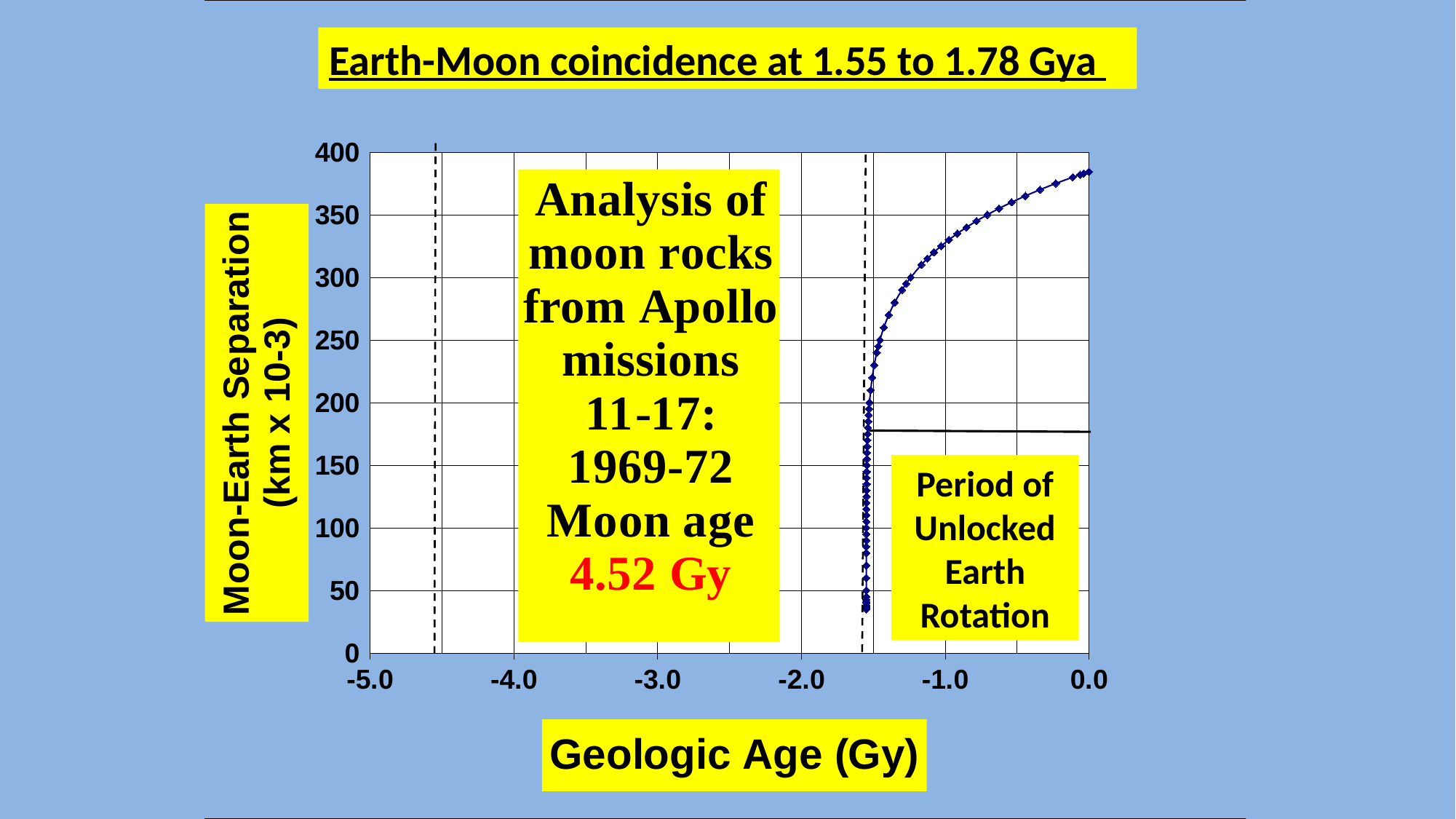
What is the title of the slide's chart? Earth-Moon coincidence at 1.55 to 1.78 Gya Which has the smaller Moon-Earth separation: Geologic Age -1.5 or Geologic Age -0.5? -1.5 What kind of chart is shown on the slide? line chart What is the highest tick value shown on the y axis? 400 What is the label of the x axis? Geologic Age (Gy) Is the Moon-Earth separation at Geologic Age -1.0 greater or less than 300? greater Does the Moon-Earth separation rise or fall as Geologic Age moves from -1.5 toward 0.0 along the x axis? rise Is the Moon-Earth separation at Geologic Age -1.5 greater or less than 300? less Which has the larger Moon-Earth separation: Geologic Age -1.0 or Geologic Age 0.0? 0.0 Is the Moon-Earth separation at Geologic Age 0.0 greater or less than 350? greater At which Geologic Age does the plotted curve reach its highest Moon-Earth separation? 0.0 What is the lowest tick value shown on the x axis? -5.0